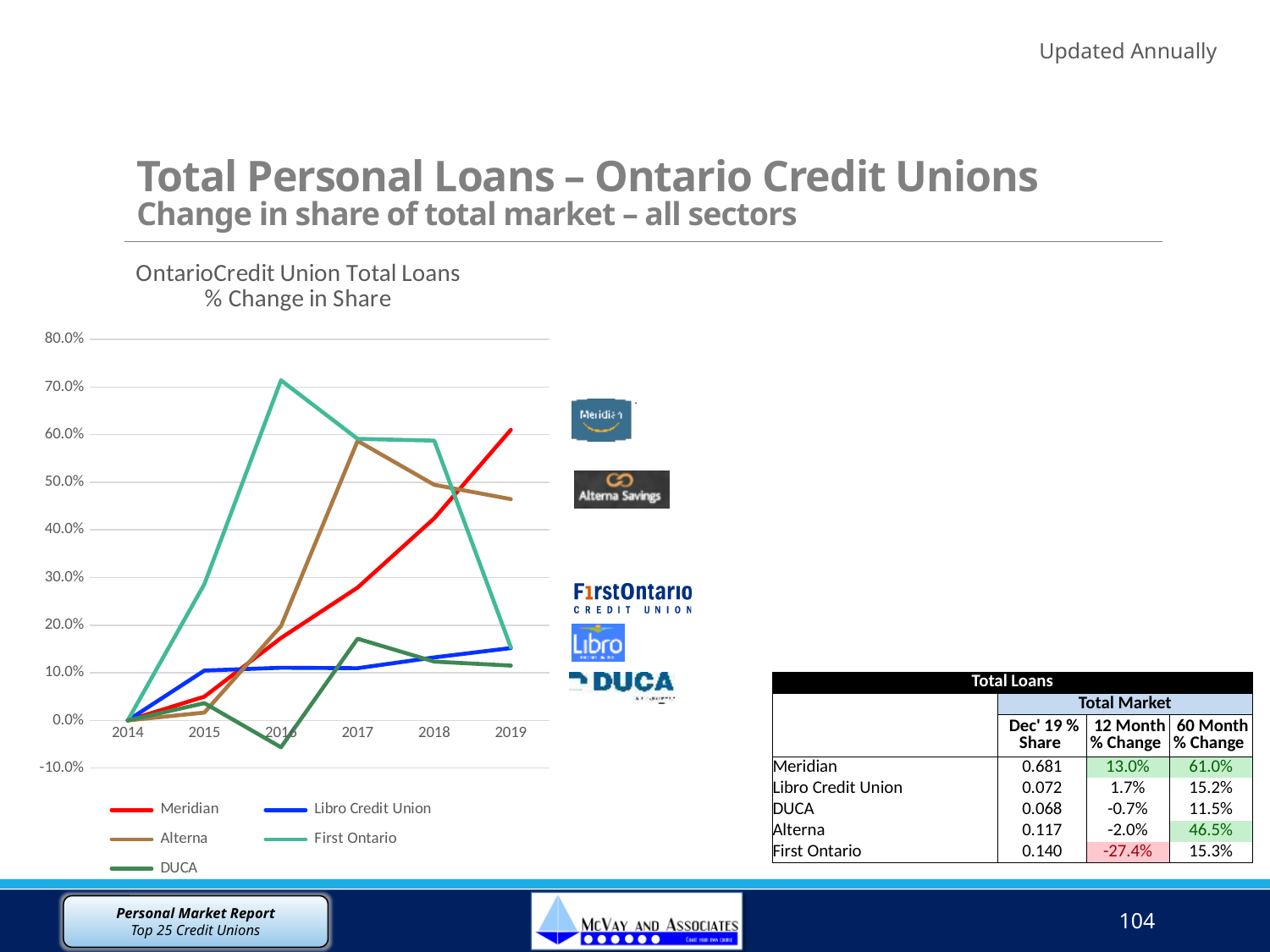
Is the value for Meridian in 2019 greater or less than 50.0%? greater Does the Meridian line rise or fall from 2014 to 2019? rise In 2018, which is larger: the value for Alterna or the value for Meridian? Alterna What colour is the Meridian line in the chart? red How many years are plotted along the x axis of the chart? 6 Is the value for DUCA in 2016 greater or less than 0.0%? less What is the title of the chart? OntarioCredit Union Total Loans % Change in Share Which credit union has the highest value in 2019? Meridian How many series does the chart legend list? 5 Is the value for First Ontario in 2016 greater or less than 60.0%? greater Which credit union has the lowest value in 2016? DUCA What kind of chart is shown on the slide? line chart